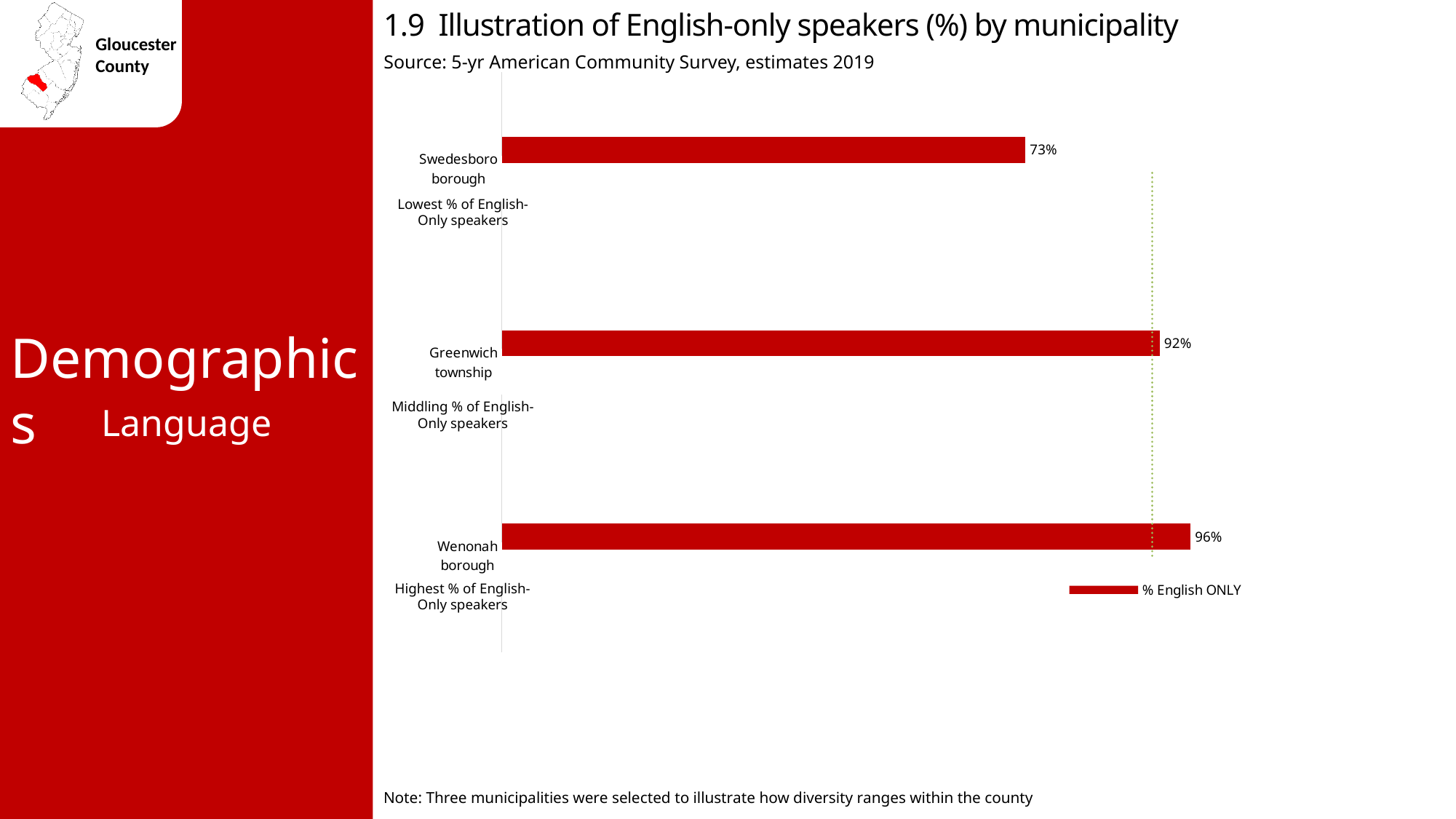
What percentage of English-only speakers is shown for Greenwich township? 92% How many series does the legend list? 1 Which municipality has the lowest percentage of English-only speakers? Swedesboro borough What type of chart is shown on the slide? Bar chart What is the difference in percentage points between Wenonah borough and Swedesboro borough? 23 How many municipalities are shown in the chart? 3 What percentage of English-only speakers is shown for Swedesboro borough? 73% What percentage of English-only speakers is shown for Wenonah borough? 96% Which has a higher percentage of English-only speakers, Greenwich township or Swedesboro borough? Greenwich township Which municipality has the highest percentage of English-only speakers? Wenonah borough What is the difference in percentage points between Greenwich township and Swedesboro borough? 19 What is the legend entry for the series in the chart? % English ONLY